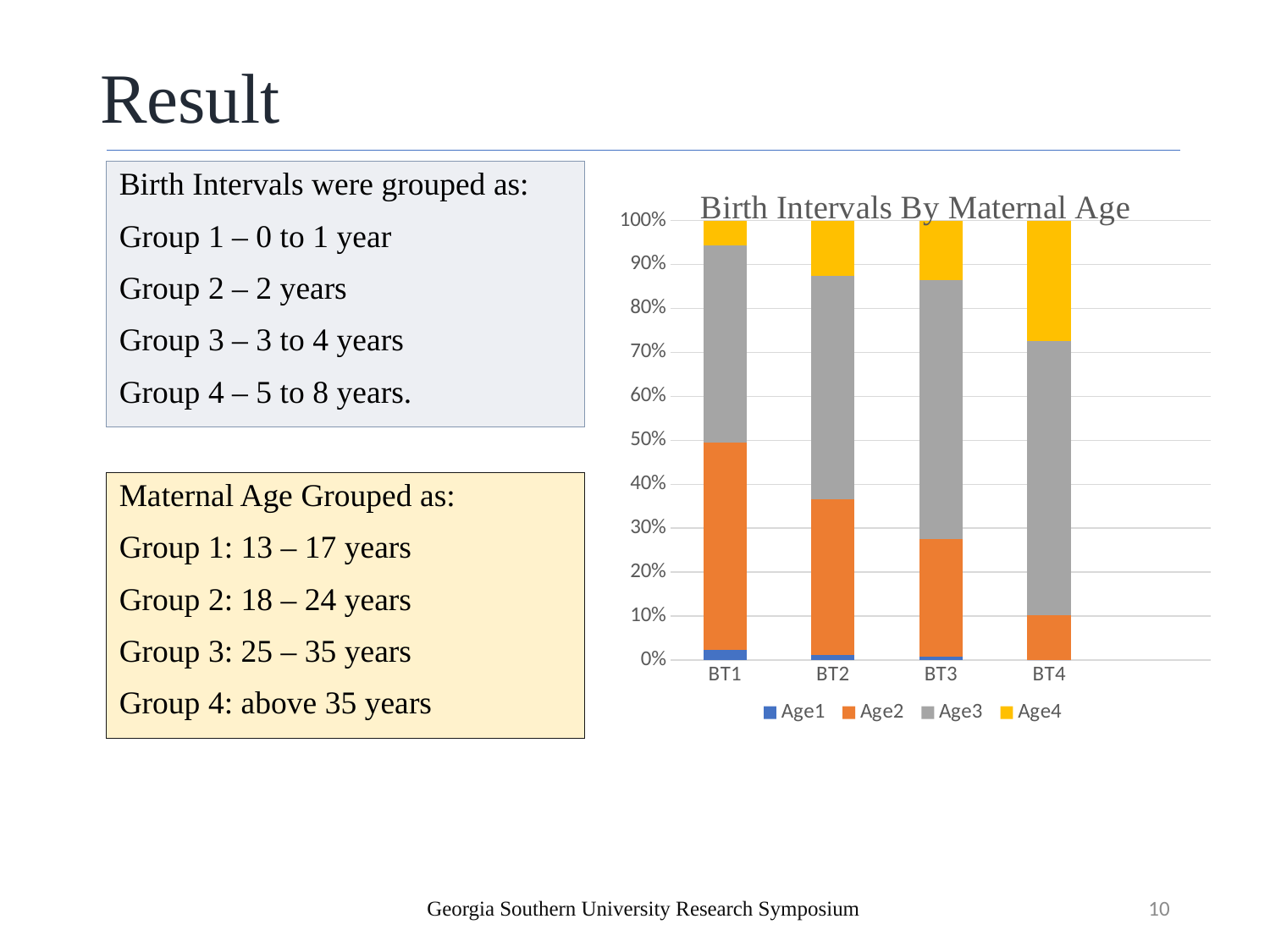
Is the Age4 share for BT4 greater or less than 20%? greater How many series does the chart legend list? 4 Which category has the largest Age4 share? BT4 What is the title of the chart? Birth Intervals By Maternal Age How many categories are shown on the x axis of the chart? 4 Does the Age2 share rise or fall from BT1 to BT4? Fall Is the Age2 share for BT4 greater or less than 20%? less Which series is shown in yellow in the chart? Age4 Is the Age2 share for BT1 larger than the Age2 share for BT4? Yes Which category has the smallest Age2 share? BT4 What kind of chart is shown on the slide? Stacked bar chart Which category has the largest Age2 share? BT1